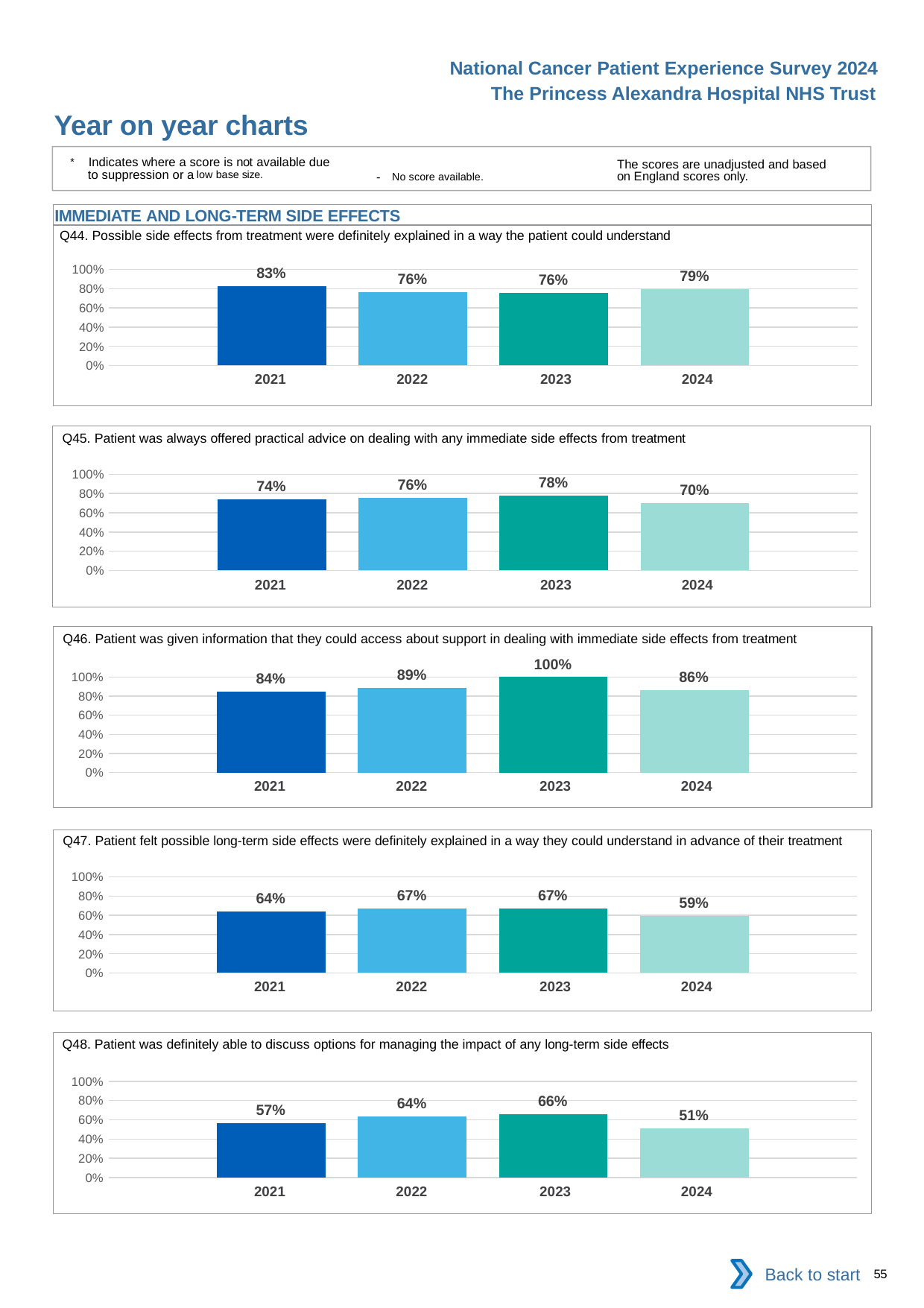
What kind of chart is the Q46 chart? bar chart In the Q48 chart, is the value for 2024 greater or less than 60%? less In the Q45 chart, which is larger, the value for 2021 or the value for 2024? 2021 In the Q48 chart, what is the difference between the 2023 and 2024 values? 15% How many years are shown in the Q44 chart? 4 In the Q46 chart, what is the difference between the 2022 and 2021 values? 5% In the Q46 chart, what is the value for 2023? 100% In the Q44 chart, what is the value for 2021? 83% In the Q45 chart, which year has the highest value? 2023 In the Q47 chart, which year has the lowest value? 2024 In the Q48 chart, do the values rise or fall from 2021 to 2023? rise What is the section heading above the Q44 chart? IMMEDIATE AND LONG-TERM SIDE EFFECTS